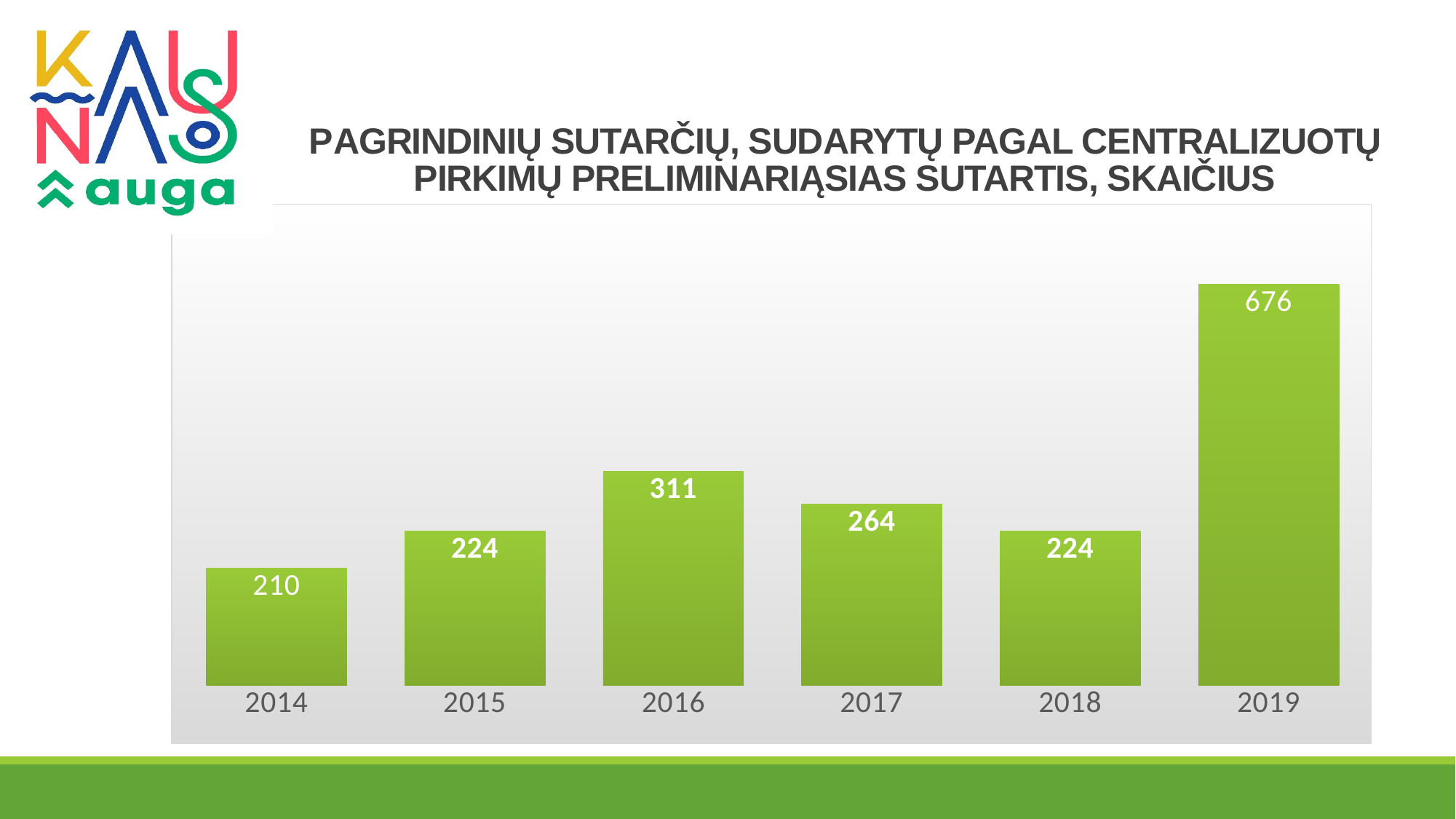
What kind of chart is shown on the slide? Bar chart Which year has the lowest value? 2014 What is the value for 2019? 676 What is the value for 2014? 210 Which two years have the same value? 2015 and 2018 Which is larger, the value for 2016 or the value for 2017? 2016 What is the value for 2016? 311 What is the difference between the values for 2019 and 2018? 452 What is the difference between the values for 2016 and 2017? 47 What is the value for 2017? 264 How many years are shown on the chart? 6 Which year has the highest value? 2019